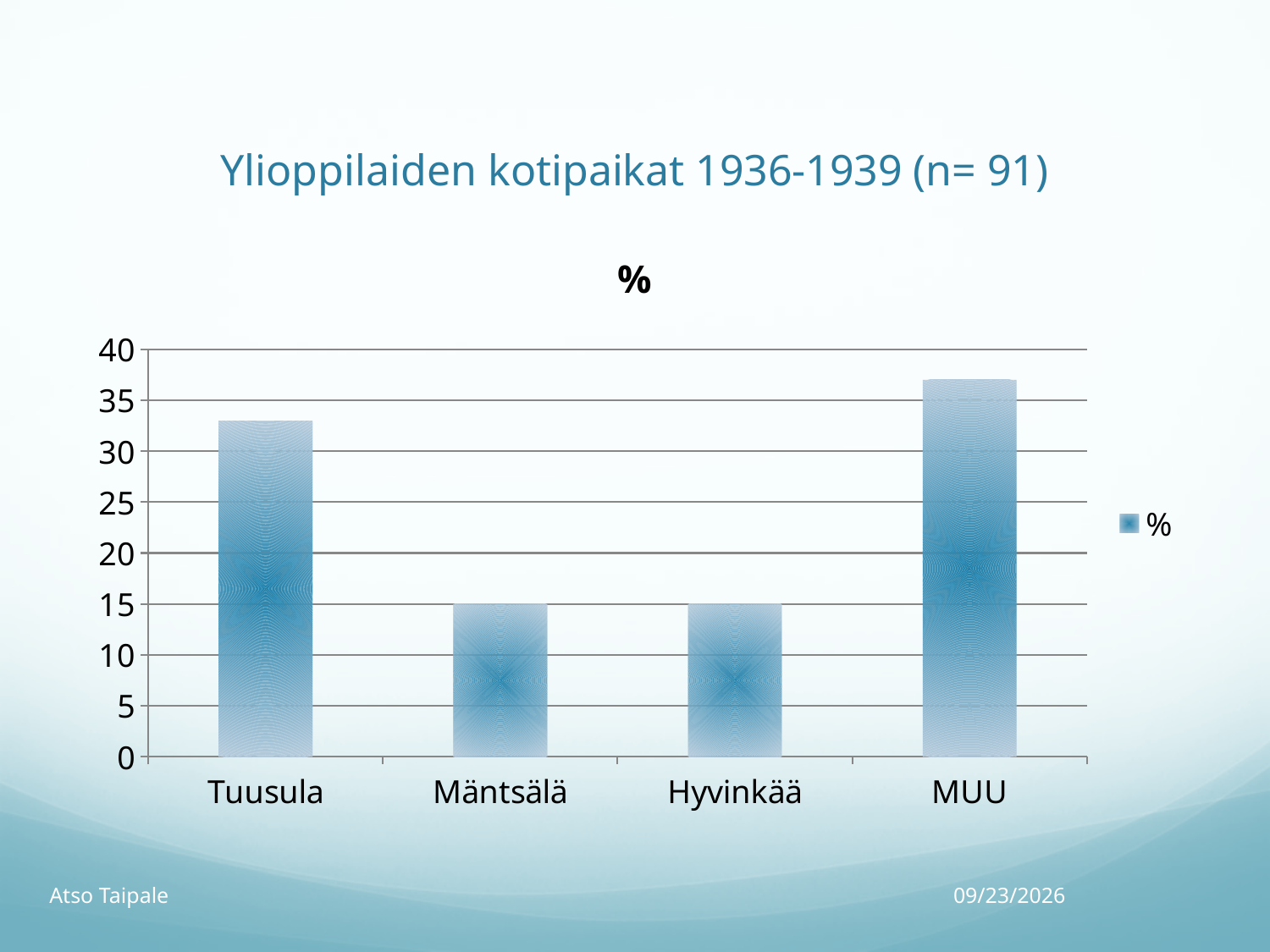
Which category has the highest value in the chart? MUU Is the value for Tuusula greater or less than 35? less Is the value for MUU greater or less than 35? greater How many series does the chart legend list? 1 What is the title shown above the chart? % What is the value for Hyvinkää? 15 Which is larger, the value for Tuusula or the value for Mäntsälä? Tuusula What type of chart is shown on the slide? bar chart Is the value for Tuusula greater or less than 30? greater What is the value for Mäntsälä? 15 Which is larger, the value for Tuusula or the value for MUU? MUU How many categories are shown on the x axis of the chart? 4